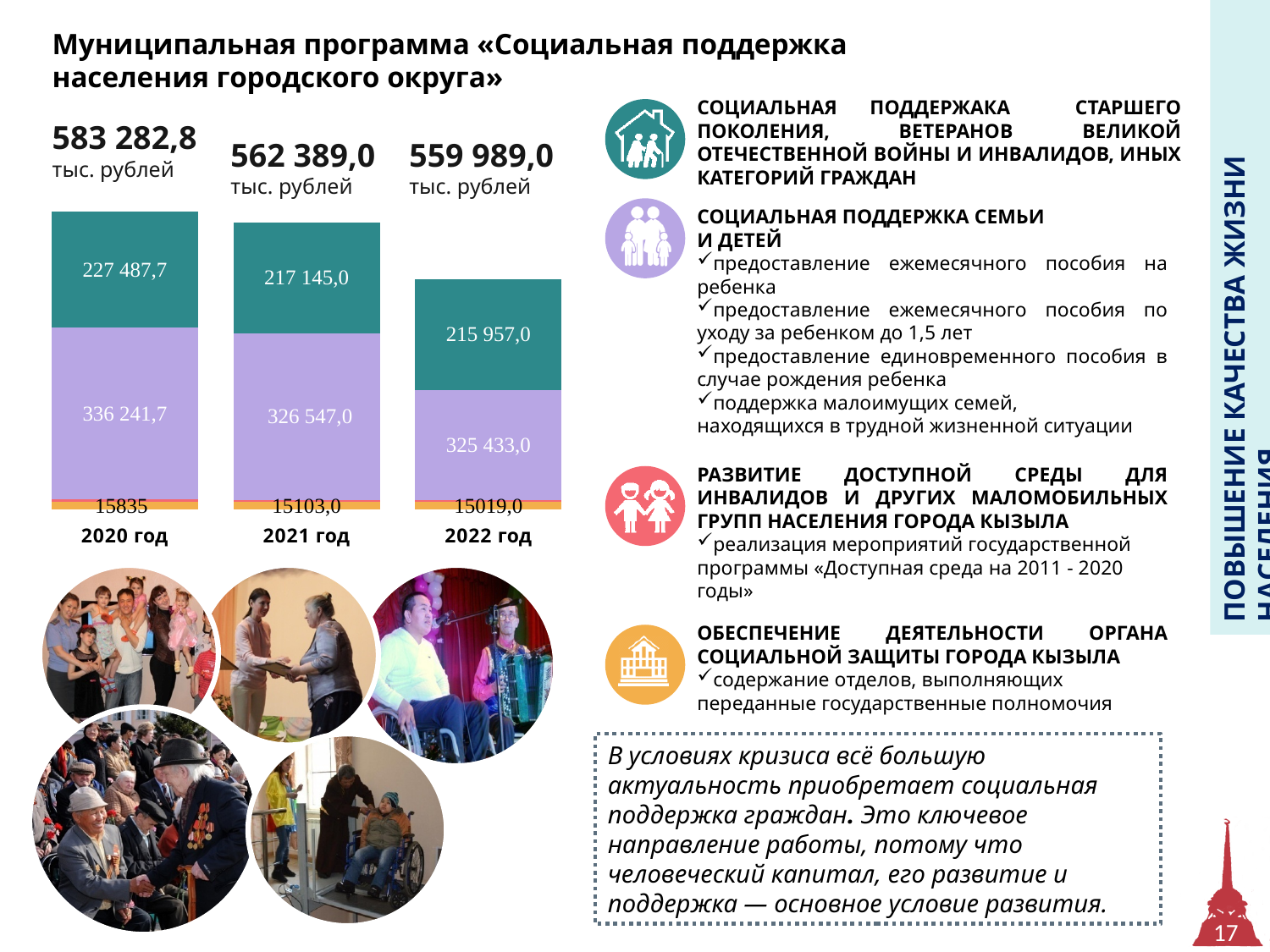
What is the value of the middle (purple) segment of the 2022 год bar? 325 433,0 What total amount is printed above the 2021 год bar? 562 389,0 тыс. рублей Which year has the highest total amount printed above its bar? 2020 год What is the value of the bottom segment of the 2021 год bar? 15103,0 What is the value of the top (teal) segment of the 2020 год bar? 227 487,7 How many years (bars) does the chart show? 3 In what units are the totals above the bars expressed? тыс. рублей What is the difference between the teal segment values for 2020 год (227 487,7) and 2021 год (217 145,0)? 10 342,7 Which year has the lowest total amount printed above its bar? 2022 год What kind of chart is shown on the left of the slide? Stacked bar chart Which is larger: the teal segment for 2020 год or the teal segment for 2022 год? 2020 год Do the total amounts printed above the bars rise or fall from 2020 to 2022? Fall